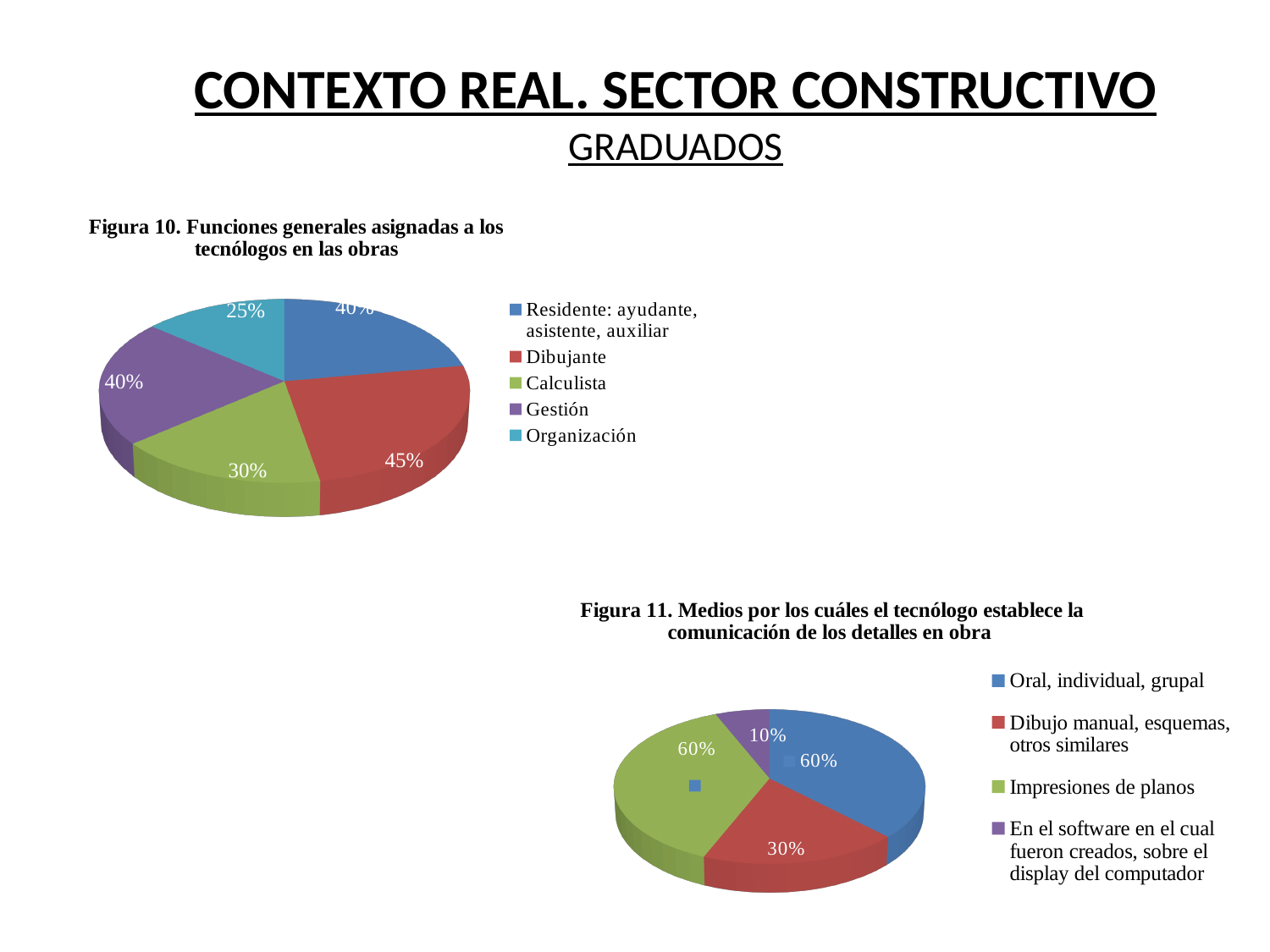
In Figura 10, which category has the lowest percentage? Organización In Figura 11 (Medios por los cuáles el tecnólogo establece la comunicación de los detalles en obra), what percentage is shown for Dibujo manual, esquemas, otros similares? 30% In Figura 10, what percentage is shown for Dibujante? 45% In Figura 11, which category has the lowest percentage? En el software en el cual fueron creados, sobre el display del computador In Figura 11, how many categories does the legend list? 4 In Figura 10, what percentage is shown for Calculista? 30% In Figura 10, which category has the highest percentage? Dibujante In Figura 11, what percentage is shown for En el software en el cual fueron creados, sobre el display del computador? 10% In Figura 10, what percentage is shown for Organización? 25% In Figura 10, how many categories does the legend list? 5 In Figura 10 (Funciones generales asignadas a los tecnólogos en las obras), what kind of chart is shown? Pie chart In Figura 10, what is the difference between the percentages for Dibujante and Calculista? 15%